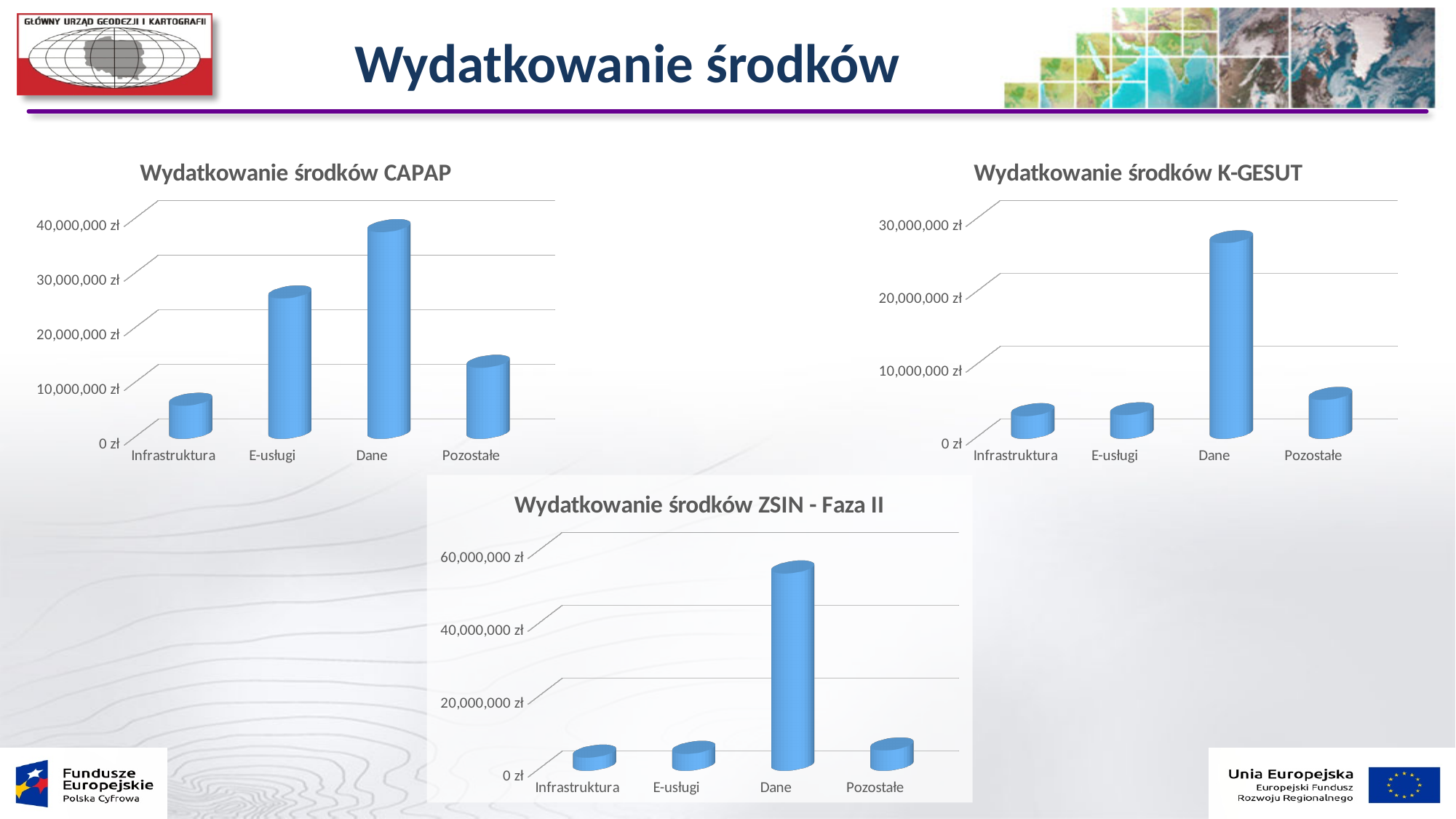
What kind of chart is "Wydatkowanie środków K-GESUT"? bar chart In the chart titled "Wydatkowanie środków K-GESUT", is the value for Pozostałe greater or less than 10,000,000 zł? less In the chart titled "Wydatkowanie środków CAPAP", which is larger, E-usługi or Pozostałe? E-usługi In the chart titled "Wydatkowanie środków ZSIN - Faza II", which category has the highest value? Dane In the chart titled "Wydatkowanie środków K-GESUT", is the value for Dane greater or less than 20,000,000 zł? greater In the chart titled "Wydatkowanie środków CAPAP", is the value for Dane greater or less than 30,000,000 zł? greater In the chart titled "Wydatkowanie środków K-GESUT", which category has the highest value? Dane How many categories are shown in the chart titled "Wydatkowanie środków ZSIN - Faza II"? 4 In the chart titled "Wydatkowanie środków CAPAP", which category has the lowest value? Infrastruktura In the chart titled "Wydatkowanie środków CAPAP", which category has the highest value? Dane